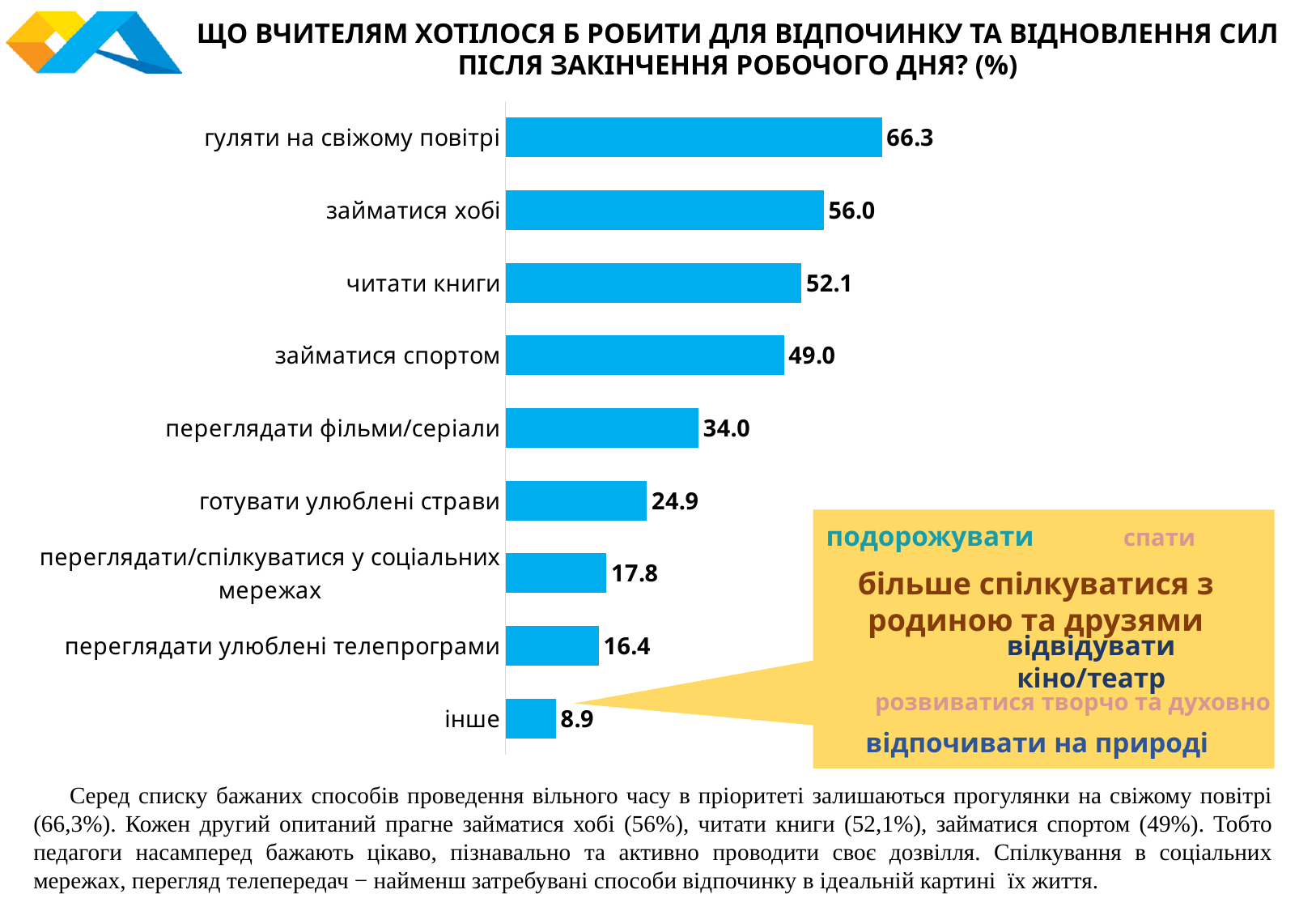
What is the value for "готувати улюблені страви"? 24.9 What is the value for "гуляти на свіжому повітрі"? 66.3 How many categories are shown in the chart? 9 Which category has the lowest value? інше What colour are the bars in the chart? blue What is the difference between the values for "гуляти на свіжому повітрі" and "займатися хобі"? 10.3 Which is larger: the value for "читати книги" or the value for "займатися спортом"? читати книги What is the value for "займатися спортом"? 49.0 Which category has the highest value? гуляти на свіжому повітрі What is the value for "переглядати улюблені телепрограми"? 16.4 What kind of chart is shown on the slide? bar chart What is the difference between the values for "переглядати фільми/серіали" and "готувати улюблені страви"? 9.1